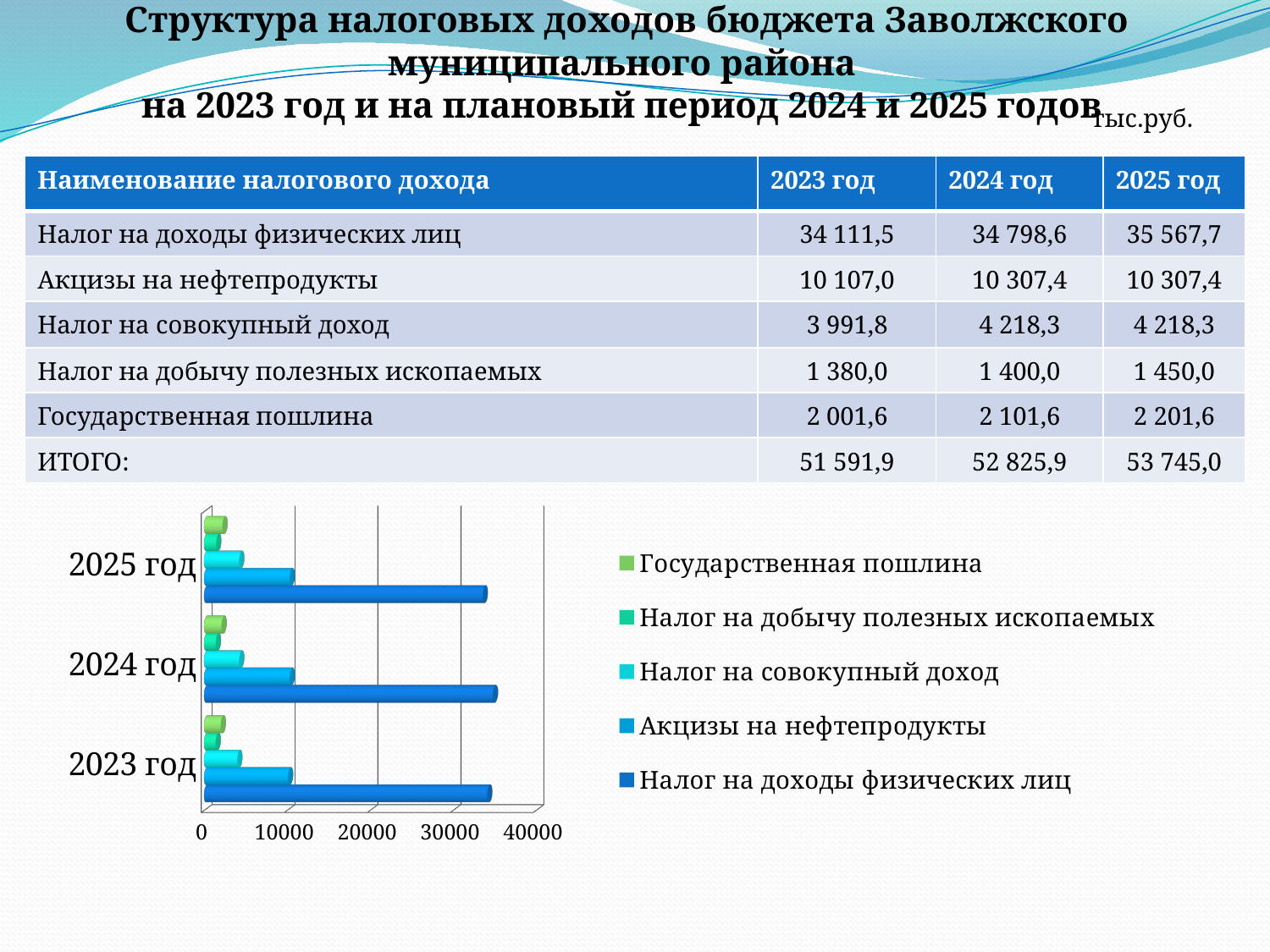
Which series has the longest bars in the chart for every year? Налог на доходы физических лиц Is the value for Налог на доходы физических лиц in 2025 год greater or less than 30000? greater How many series does the chart legend list? 5 What kind of chart is shown on the slide? bar chart According to the table, what is the value of Налог на доходы физических лиц for 2025 год? 35 567,7 Which is larger in 2025 год: Акцизы на нефтепродукты or Налог на совокупный доход? Акцизы на нефтепродукты Is the value for Акцизы на нефтепродукты in 2024 год greater or less than 20000? less How many year categories does the bar chart show? 3 According to the table, what is the value of Государственная пошлина for 2023 год? 2 001,6 Is the value for Налог на доходы физических лиц in 2023 год greater or less than 40000? less Does the value for Налог на доходы физических лиц rise or fall from 2023 год to 2025 год? rise